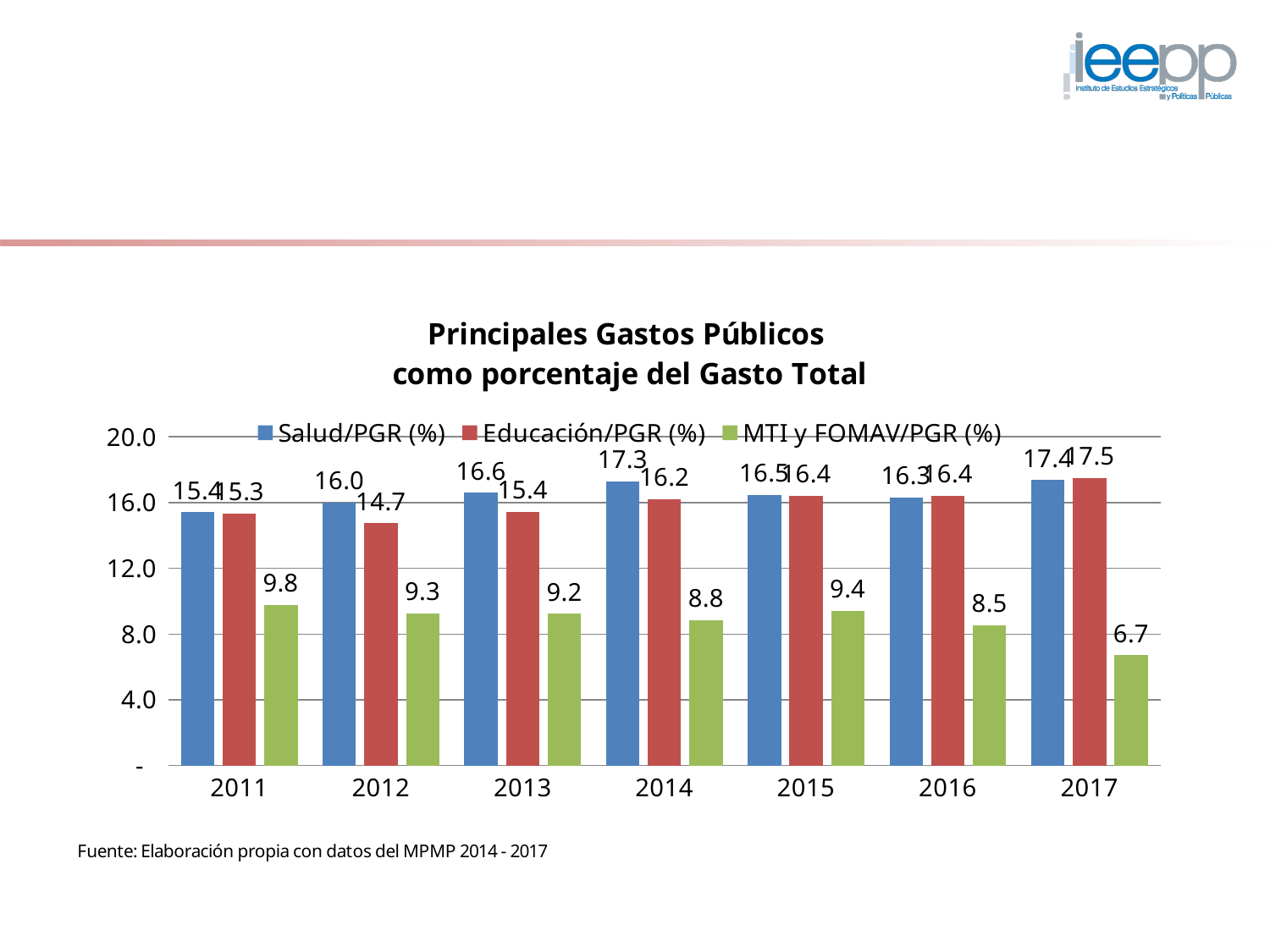
What is the difference between Salud/PGR (%) and Educación/PGR (%) in 2013? 1.2 What is the value of MTI y FOMAV/PGR (%) in 2017? 6.7 Does Educación/PGR (%) rise or fall from 2012 to 2017? rise In 2012, which is larger: Salud/PGR (%) or Educación/PGR (%)? Salud/PGR (%) Is the value for MTI y FOMAV/PGR (%) in 2014 greater or less than 12.0? less What is the value of Educación/PGR (%) in 2012? 14.7 How many years are shown on the x axis? 7 In which year is MTI y FOMAV/PGR (%) highest? 2011 In which year is MTI y FOMAV/PGR (%) lowest? 2017 How many series does the legend list? 3 What is the value of Salud/PGR (%) in 2014? 17.3 What kind of chart is shown on the slide? bar chart